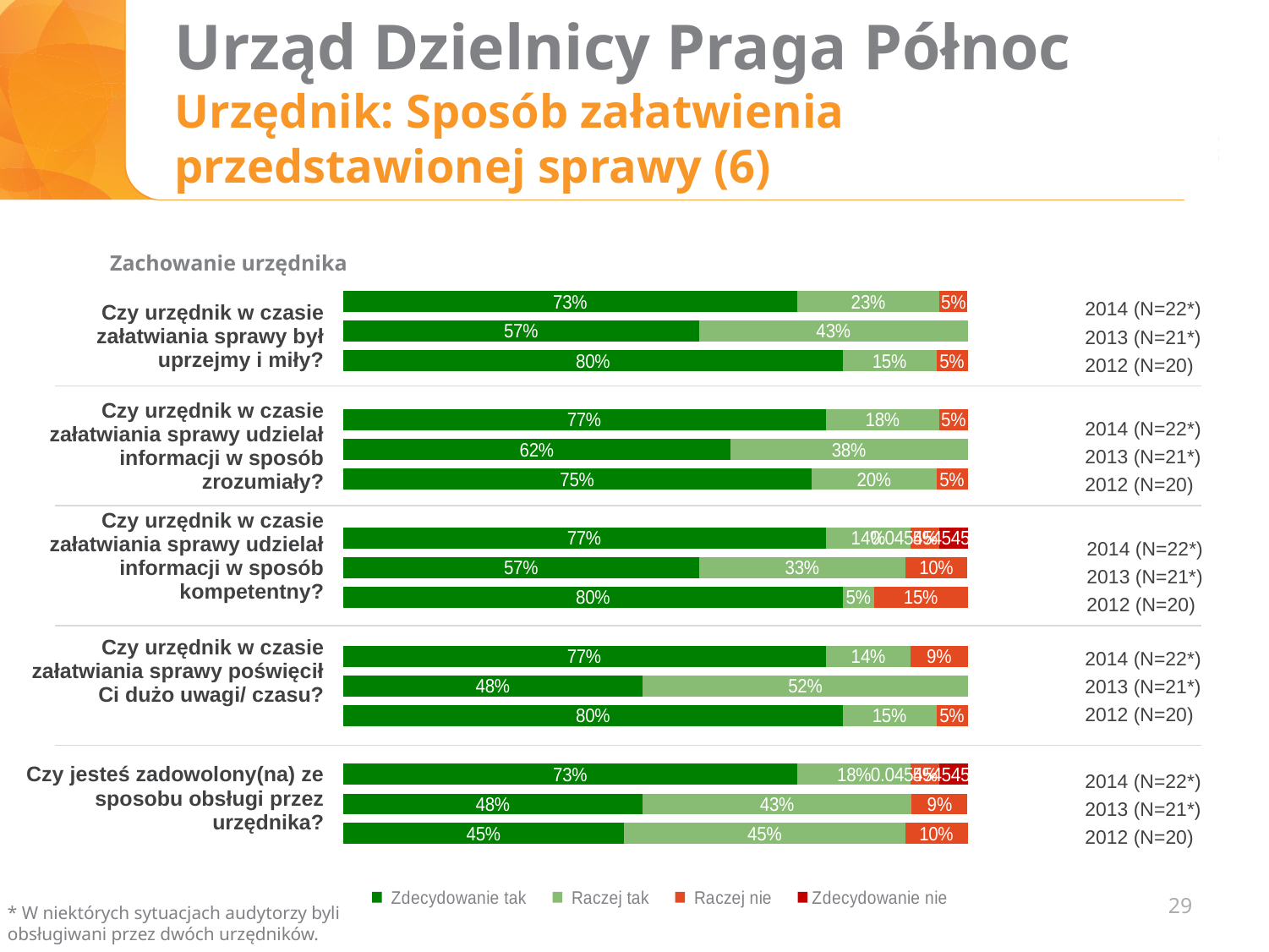
What is the 'Raczej nie' value for 2012 for the question 'Czy jesteś zadowolony(na) ze sposobu obsługi przez urzędnika?'? 10% For the question 'Czy jesteś zadowolony(na) ze sposobu obsługi przez urzędnika?', which year has the lowest 'Zdecydowanie tak' value? 2012 How many years are shown for each question in the chart? 3 How many series does the legend list? 4 What is the 'Zdecydowanie tak' value for 2013 for the question 'Czy urzędnik w czasie załatwiania sprawy udzielał informacji w sposób zrozumiały?'? 62% What is the difference between the 'Zdecydowanie tak' values for 2014 and 2013 for the question 'Czy urzędnik w czasie załatwiania sprawy poświęcił Ci dużo uwagi/ czasu?'? 29 percentage points What kind of chart is shown on the slide? Stacked bar chart For the question 'Czy urzędnik w czasie załatwiania sprawy był uprzejmy i miły?', which year has the highest 'Zdecydowanie tak' value? 2012 What is the 'Zdecydowanie tak' value for 2014 for the question 'Czy urzędnik w czasie załatwiania sprawy był uprzejmy i miły?'? 73% Which legend entry is shown in dark red? Zdecydowanie nie For the question 'Czy urzędnik w czasie załatwiania sprawy udzielał informacji w sposób kompetentny?', is the 'Raczej nie' value larger in 2013 or in 2012? 2012 What is the 'Raczej tak' value for 2013 for the question 'Czy urzędnik w czasie załatwiania sprawy poświęcił Ci dużo uwagi/ czasu?'? 52%